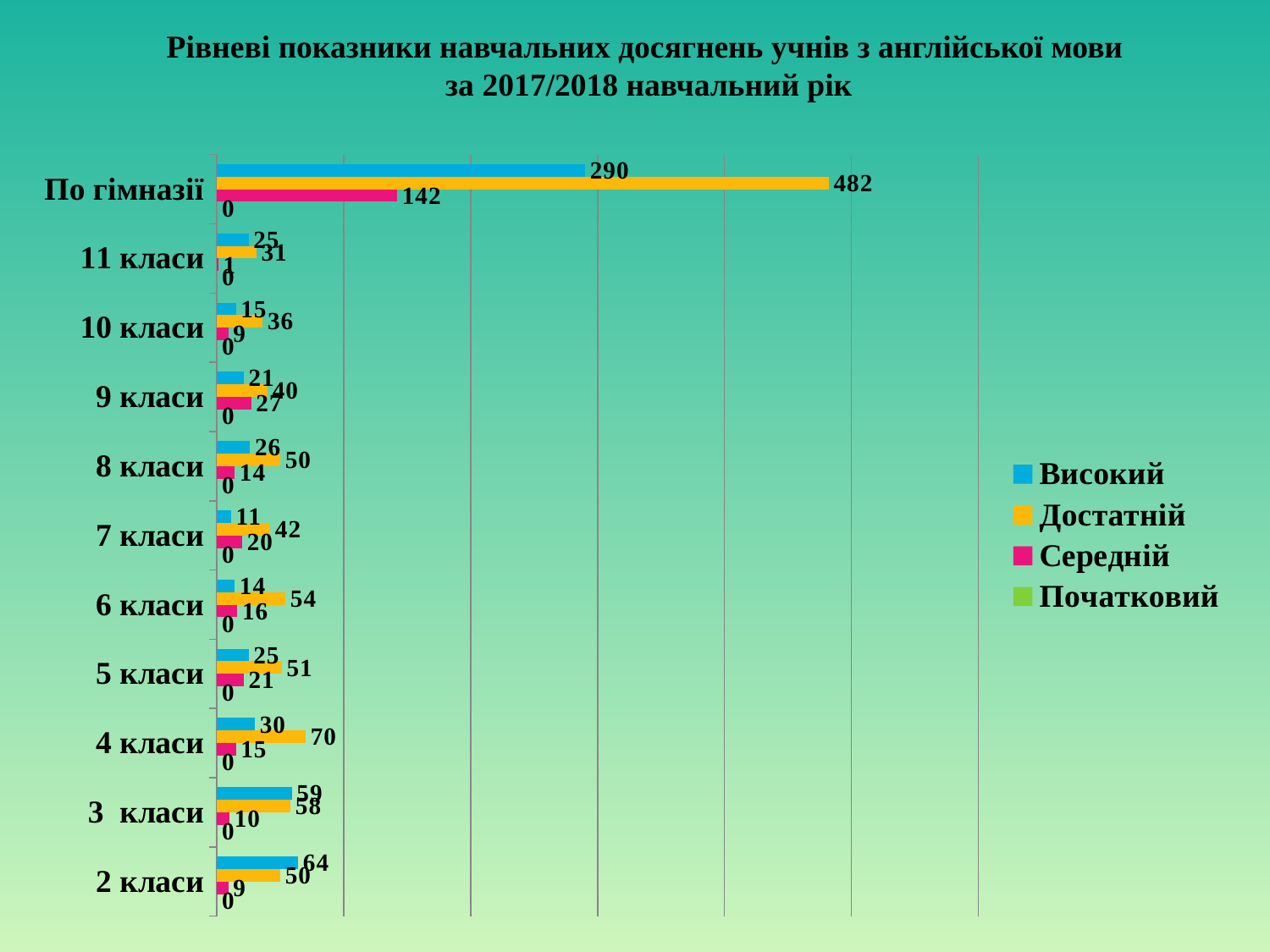
Which class category has the highest Достатній value (excluding По гімназії)? 4 класи What is the value of Достатній for По гімназії? 482 What is the difference between the Достатній and Високий values for По гімназії? 192 Which is larger for 2 класи: Високий or Достатній? Високий How many series does the legend list? 4 Which series is shown in pink? Середній What kind of chart is shown on the slide? bar chart What is the value of Середній for 9 класи? 27 What is the total of Високий, Достатній, Середній and Початковий for 8 класи? 90 Which class category has the lowest Середній value? 11 класи What is the value of Високий for 4 класи? 30 How many categories are shown on the vertical axis? 11